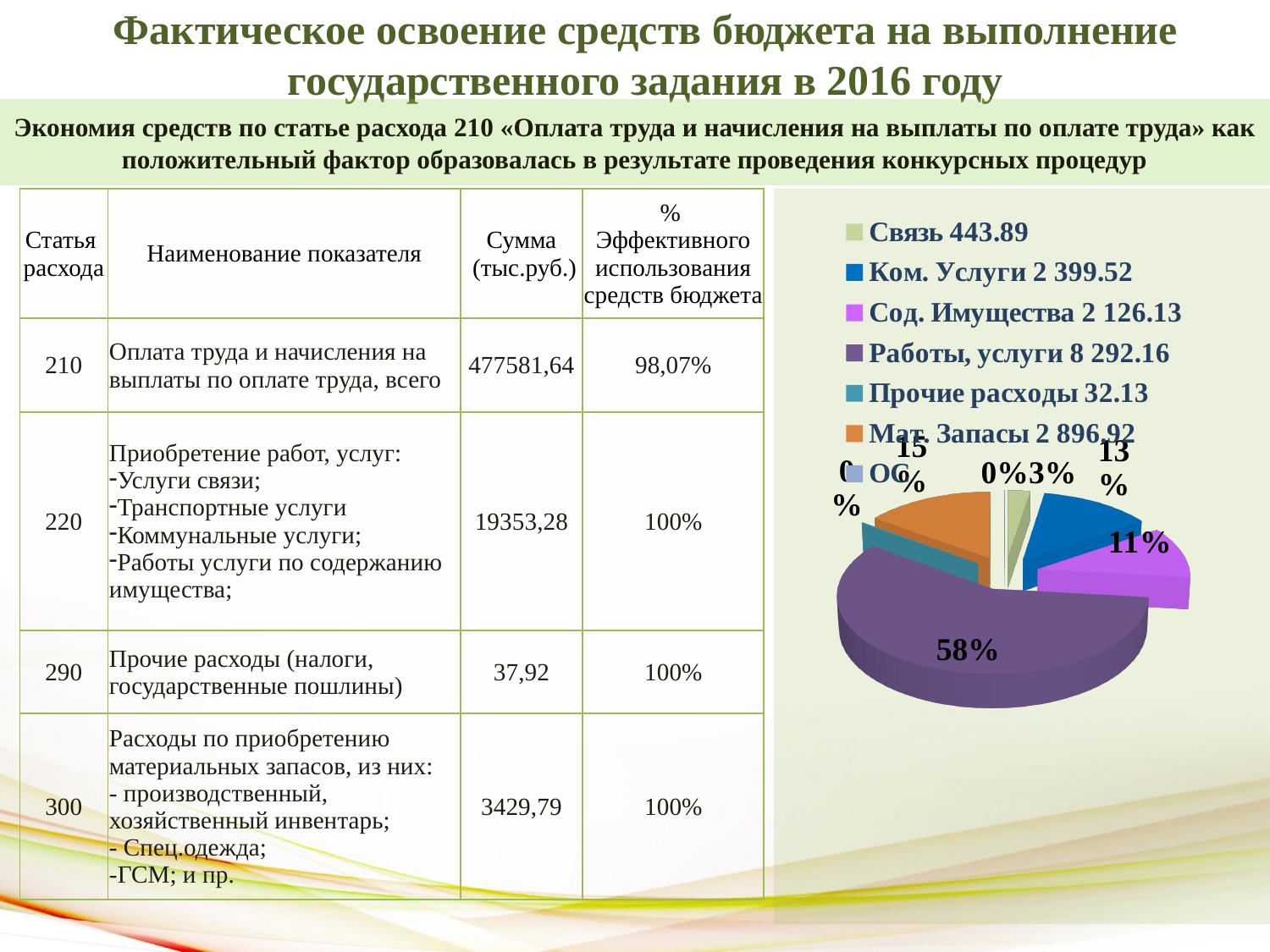
What percentage label is shown for the Ком. Услуги slice? 13% What value is listed in the legend for Работы, услуги? 8 292.16 What value is listed in the legend for Прочие расходы? 32.13 What percentage label is shown for the Связь slice? 3% What percentage label is shown for the Мат. Запасы slice? 15% What kind of chart is shown on the right side of the slide? pie chart What colour is the Работы, услуги slice in the pie chart? purple Which slice is larger, Ком. Услуги or Сод. Имущества? Ком. Услуги What value is listed in the legend for Связь? 443.89 Which category has the largest slice of the pie chart? Работы, услуги